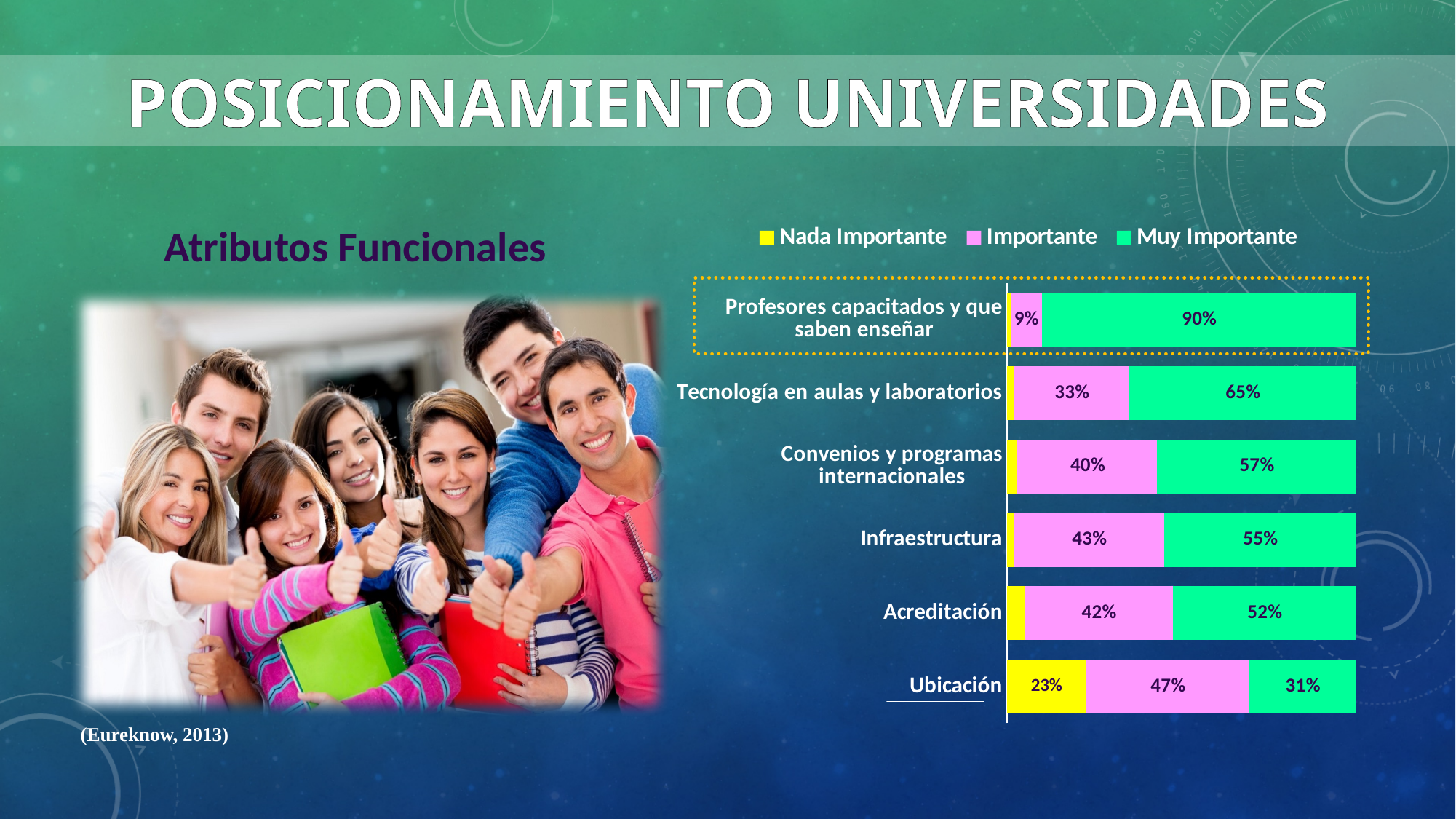
What is the Muy Importante value for Acreditación? 52% Which colour represents the Nada Importante series in the legend? Yellow How many series does the legend list? 3 What kind of chart is shown on the slide? Stacked bar chart What is the difference between the Muy Importante and Importante values for Tecnología en aulas y laboratorios? 32 percentage points What is the Nada Importante value for Ubicación? 23% What is the Importante value for Tecnología en aulas y laboratorios? 33% Which is larger for Infraestructura: the Importante value or the Muy Importante value? Muy Importante What is the Muy Importante value for Profesores capacitados y que saben enseñar? 90% How many categories are shown in the chart? 6 Which category has the highest Muy Importante value? Profesores capacitados y que saben enseñar Which category has the lowest Muy Importante value? Ubicación